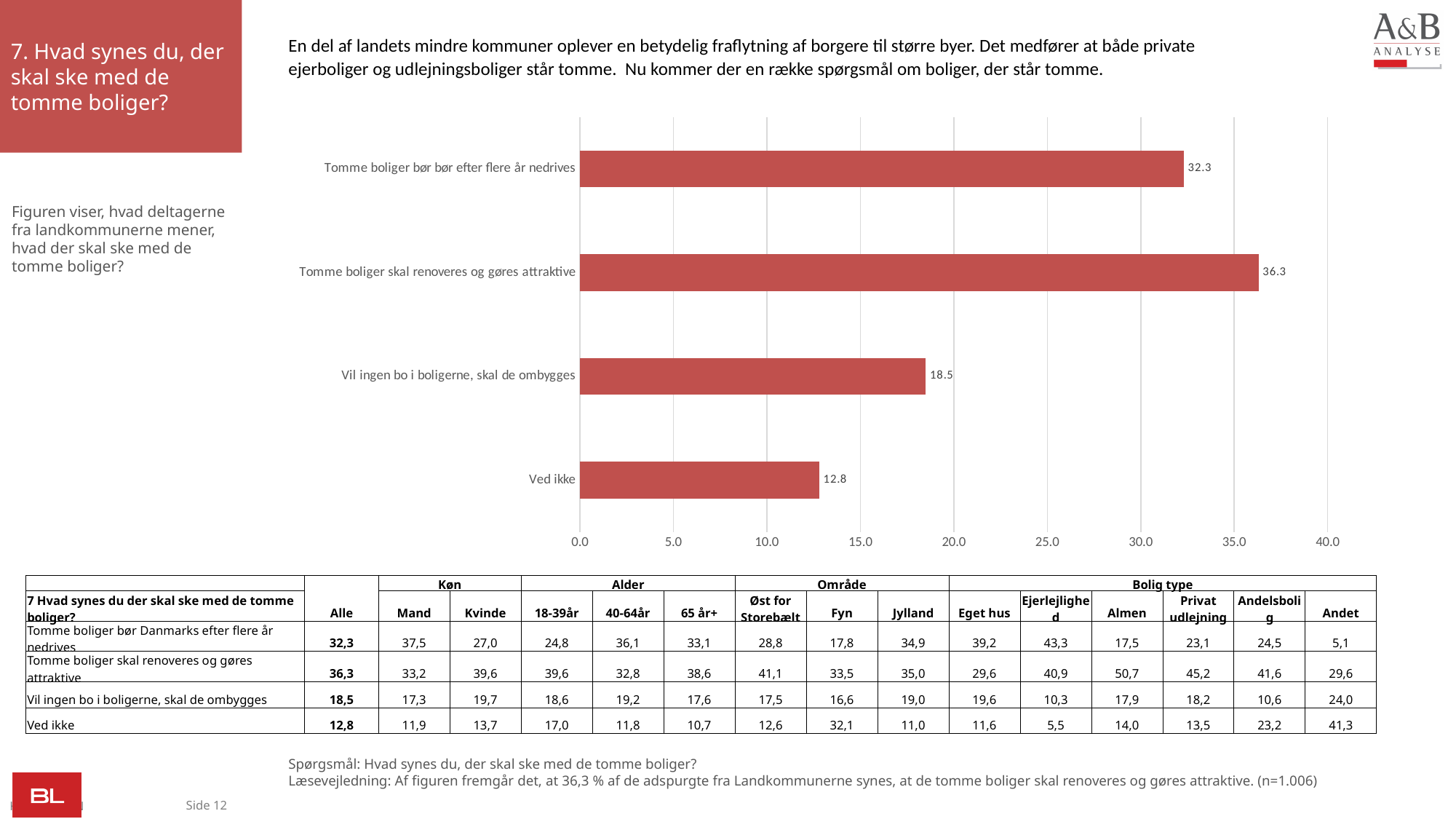
Which is larger: the value for "Vil ingen bo i boligerne, skal de ombygges" or the value for "Ved ikke"? Vil ingen bo i boligerne, skal de ombygges What is the value for "Ved ikke"? 12.8 Which category has the lowest value? Ved ikke What is the value for "Tomme boliger skal renoveres og gøres attraktive"? 36.3 What kind of chart is shown on the slide? Bar chart What is the maximum value shown on the chart's horizontal axis? 40.0 How many categories are shown in the chart? 4 Is the value for "Tomme boliger bør bør efter flere år nedrives" greater or less than 30.0? greater What is the value for "Tomme boliger bør bør efter flere år nedrives"? 32.3 Which category has the highest value? Tomme boliger skal renoveres og gøres attraktive What is the difference between the values for "Tomme boliger skal renoveres og gøres attraktive" and "Tomme boliger bør bør efter flere år nedrives"? 4.0 What is the value for "Vil ingen bo i boligerne, skal de ombygges"? 18.5